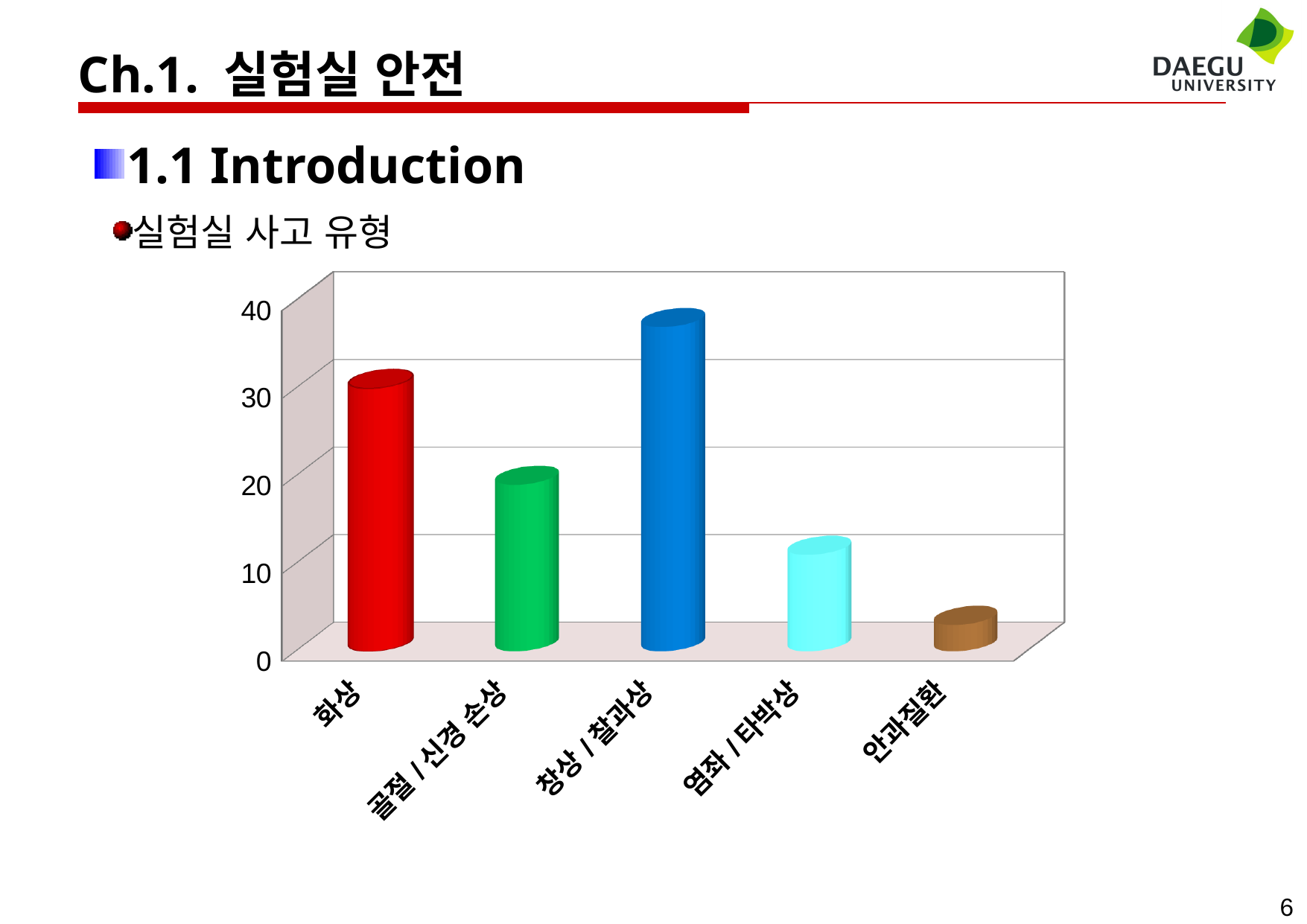
How many categories are shown on the x axis of the chart? 5 Is the value for 화상 greater or less than 20? greater Which category has the lowest bar in the chart? 안과질환 Which category has the highest bar in the chart? 창상 / 찰과상 Which is larger, the value for 화상 or the value for 골절 / 신경 손상? 화상 Is the value for 안과질환 greater or less than 10? less Is the value for 창상 / 찰과상 greater or less than 30? greater Which is larger, the value for 염좌 / 타박상 or the value for 안과질환? 염좌 / 타박상 What is the highest value shown on the vertical axis of the chart? 40 What kind of chart is shown on the slide? bar chart